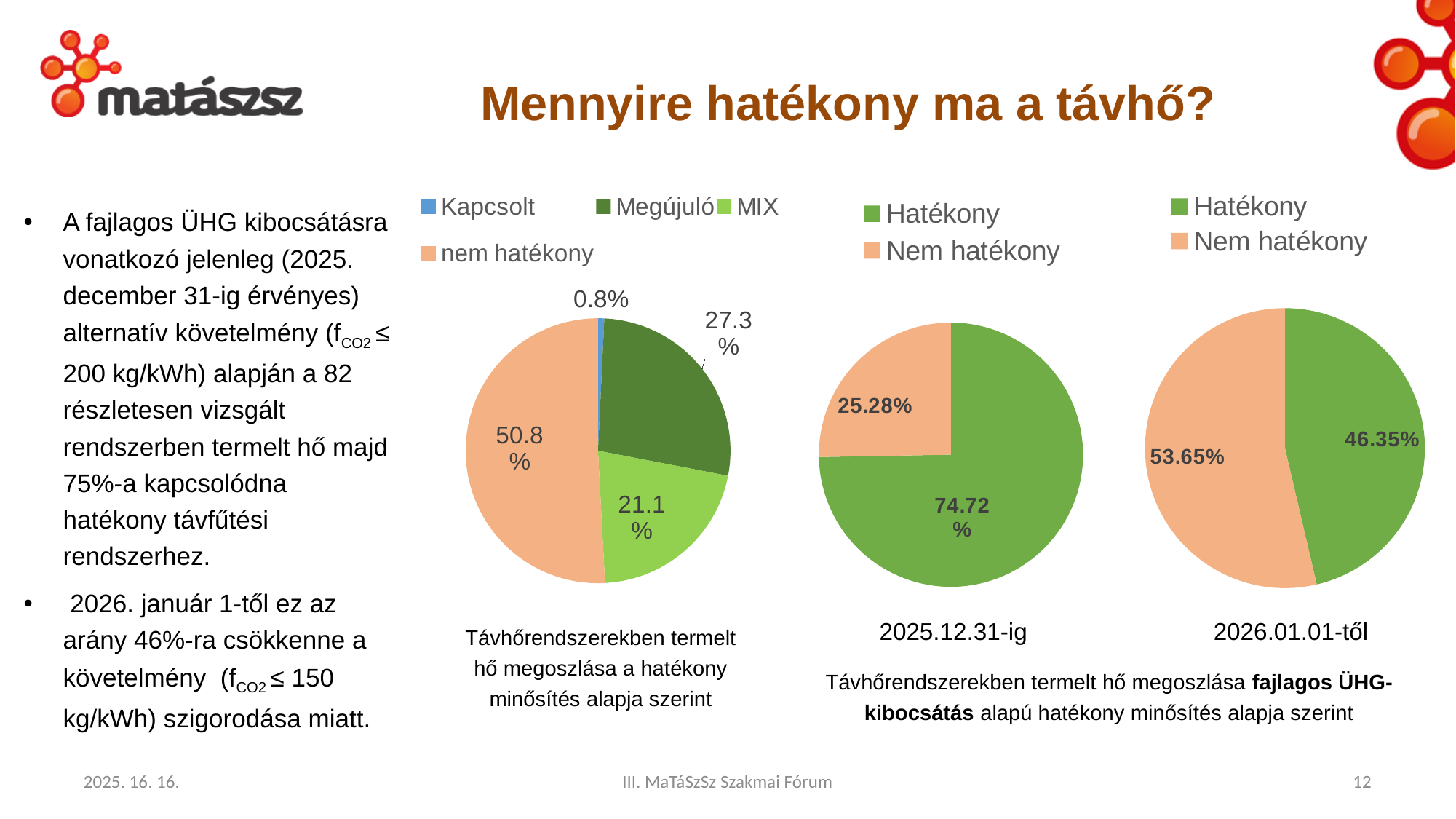
In the pie chart labelled '2025.12.31-ig', what is the share of 'Hatékony'? 74.72% What type of chart is used for the '2025.12.31-ig' data? Pie chart In the pie chart labelled '2026.01.01-től', which is larger, 'Hatékony' or 'Nem hatékony'? Nem hatékony In the pie chart labelled '2026.01.01-től', what is the share of 'Nem hatékony'? 53.65% In the left pie chart, what is the difference between 'Megújuló' and 'MIX'? 6.2% In the left pie chart, which category has the largest share? nem hatékony How many categories does the legend of the left pie chart list? 4 In the left pie chart, which category has the smallest share? Kapcsolt In the left pie chart, what share does 'nem hatékony' have? 50.8% In the left pie chart, what is the value for 'Kapcsolt'? 0.8% What is the difference between the 'Hatékony' share in the '2025.12.31-ig' chart and the 'Hatékony' share in the '2026.01.01-től' chart? 28.37% In the left pie chart, what is the value for 'Megújuló'? 27.3%